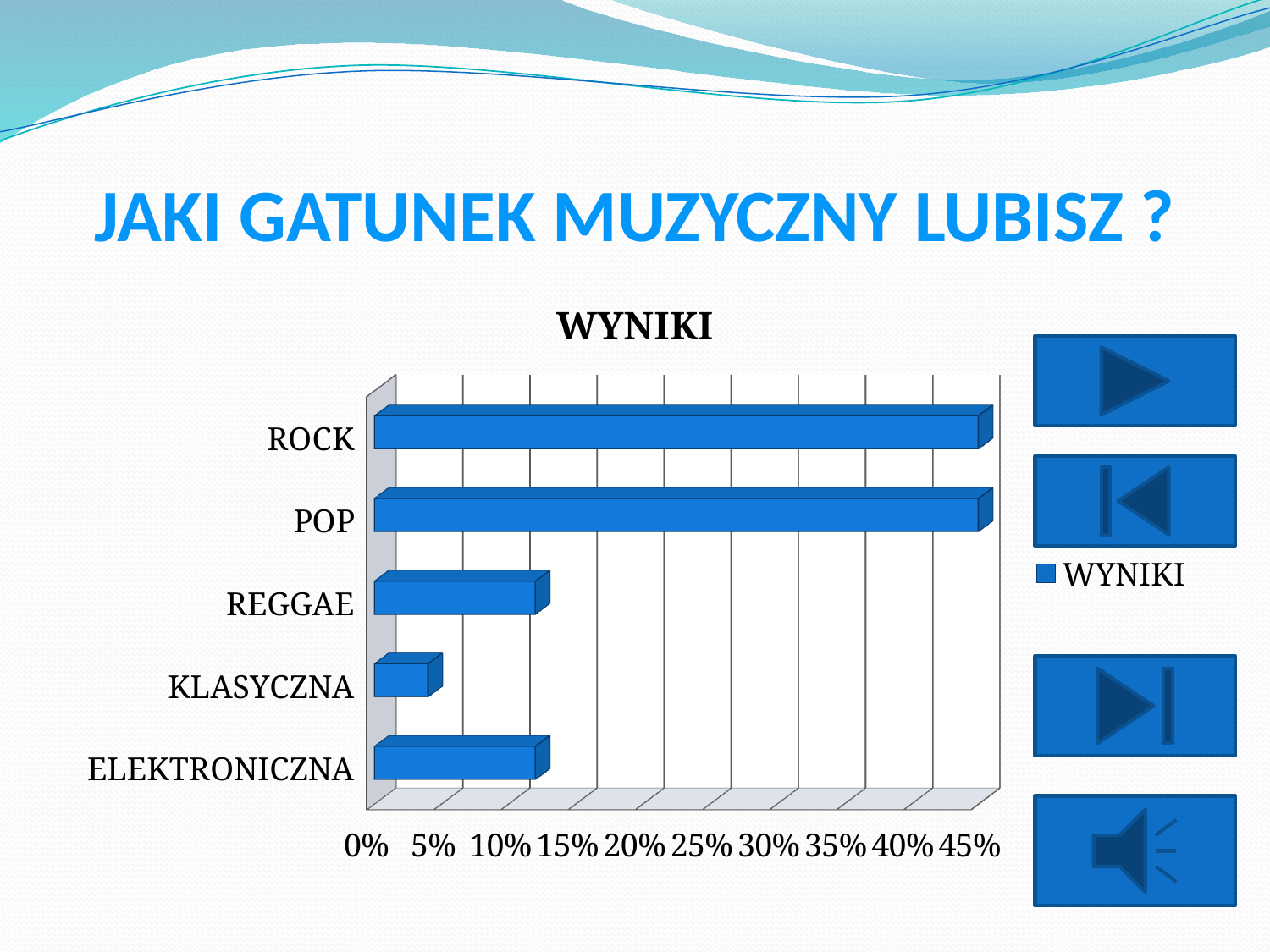
How many categories are plotted in the chart? 5 What kind of chart is shown on the slide? bar chart Is the value for KLASYCZNA greater or less than 10%? less Is the value for POP greater or less than 40%? greater Is the value for ELEKTRONICZNA greater or less than 20%? less Which is larger, the value for ROCK or the value for REGGAE? ROCK Which is larger, the value for KLASYCZNA or the value for ELEKTRONICZNA? ELEKTRONICZNA How many series does the legend list? 1 What is the title of the chart? WYNIKI Which category has the lowest value? KLASYCZNA